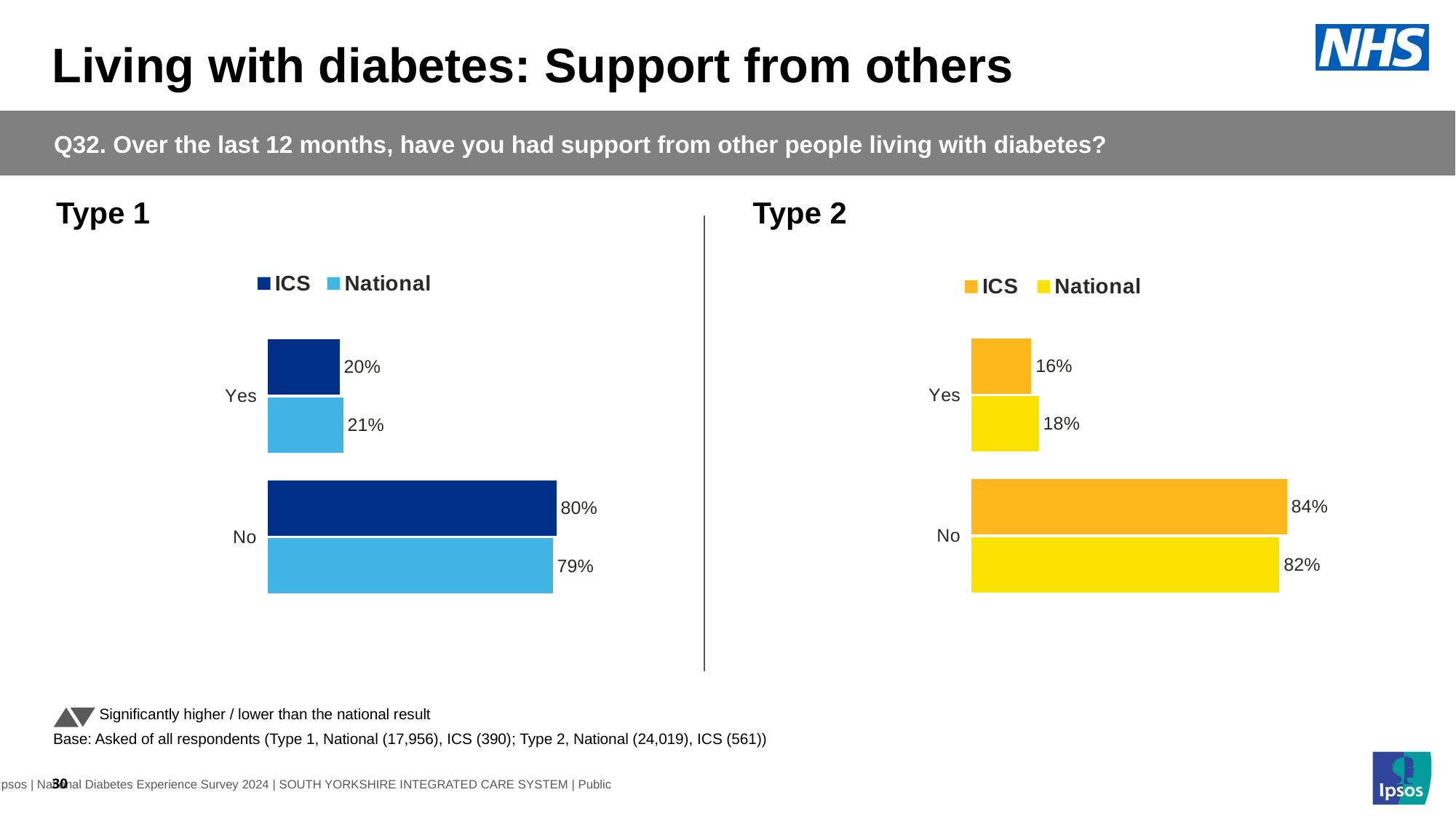
In the Type 1 chart, which category has the highest ICS value? No In the Type 1 chart, which is larger for Yes: the ICS value or the National value? National In the Type 2 chart, what is the difference between the ICS and National values for No? 2% How many series does the legend of the Type 1 chart list? 2 In the Type 2 chart, which category has the lowest National value? Yes In the Type 2 chart, what is the National value for Yes? 18% What are the two series named in the legend of the Type 2 chart? ICS and National In the Type 2 chart, what is the ICS value for No? 84% What kind of chart is the Type 2 chart? Bar chart In the Type 1 chart, what is the ICS value for Yes? 20% In the Type 1 chart, what is the National value for No? 79% How many categories are shown in the Type 2 chart? 2